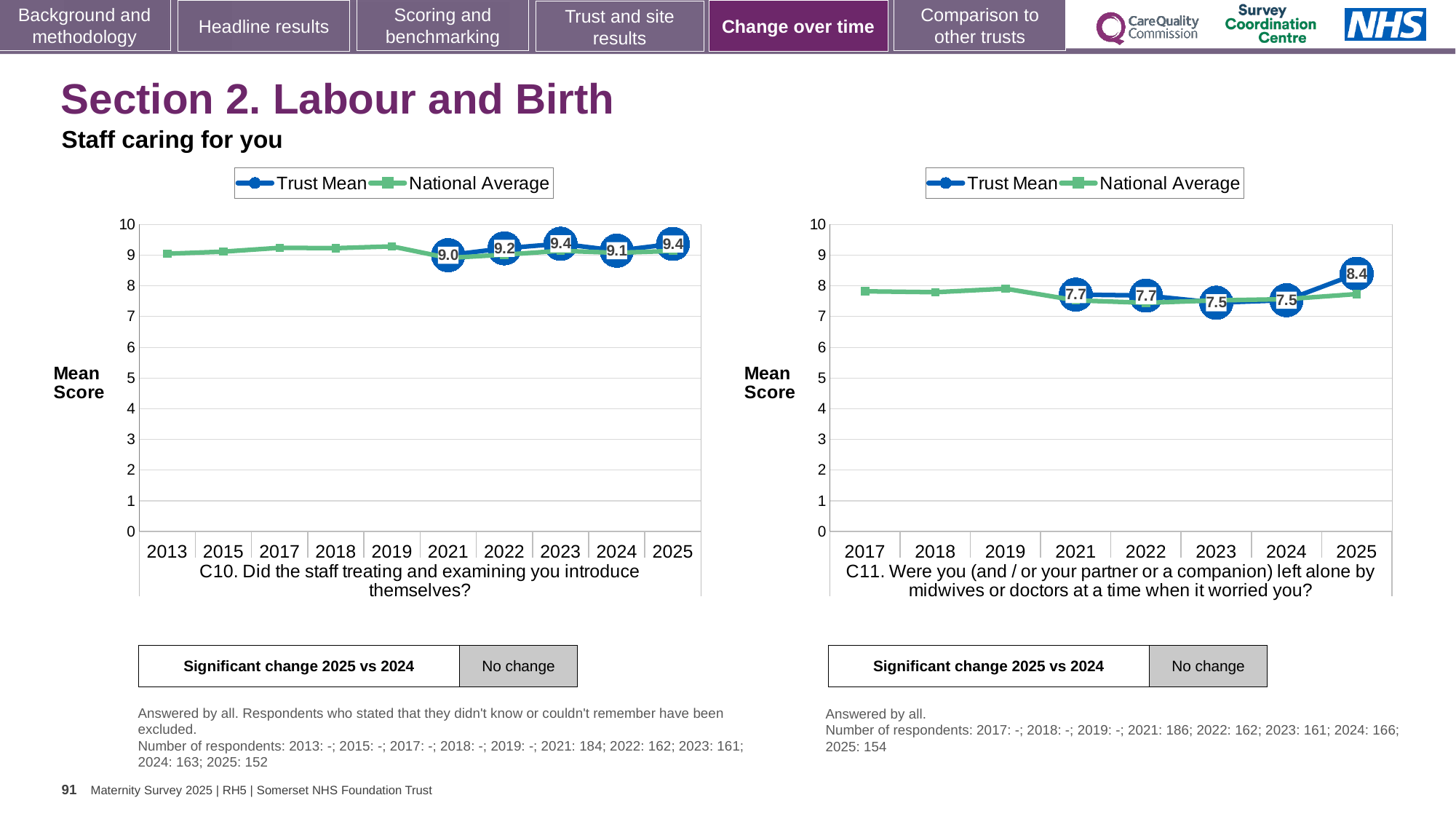
In the C11 chart on the right, which year has the highest Trust Mean score? 2025 In the C11 chart on the right, what is the difference between the Trust Mean scores for 2025 and 2024? 0.9 How many years are shown on the x axis of the C11 chart on the right? 8 In the C10 chart on the left, which year has the lowest labelled Trust Mean score? 2021 In the C11 chart on the right, what is the Trust Mean score for 2023? 7.5 In the C10 chart on the left, is the National Average value for 2013 greater or less than 8? greater How many series does the legend of the C10 chart on the left list? 2 In the C10 chart on the left, what is the difference between the Trust Mean scores for 2025 and 2024? 0.3 In the C11 chart on the right, what is the Trust Mean score for 2025? 8.4 In the C11 chart on the right, is the Trust Mean score higher in 2025 or in 2024? 2025 In the C10 chart on the left, what is the Trust Mean score for 2021? 9.0 In the C10 chart on the left, what is the Trust Mean score for 2025? 9.4